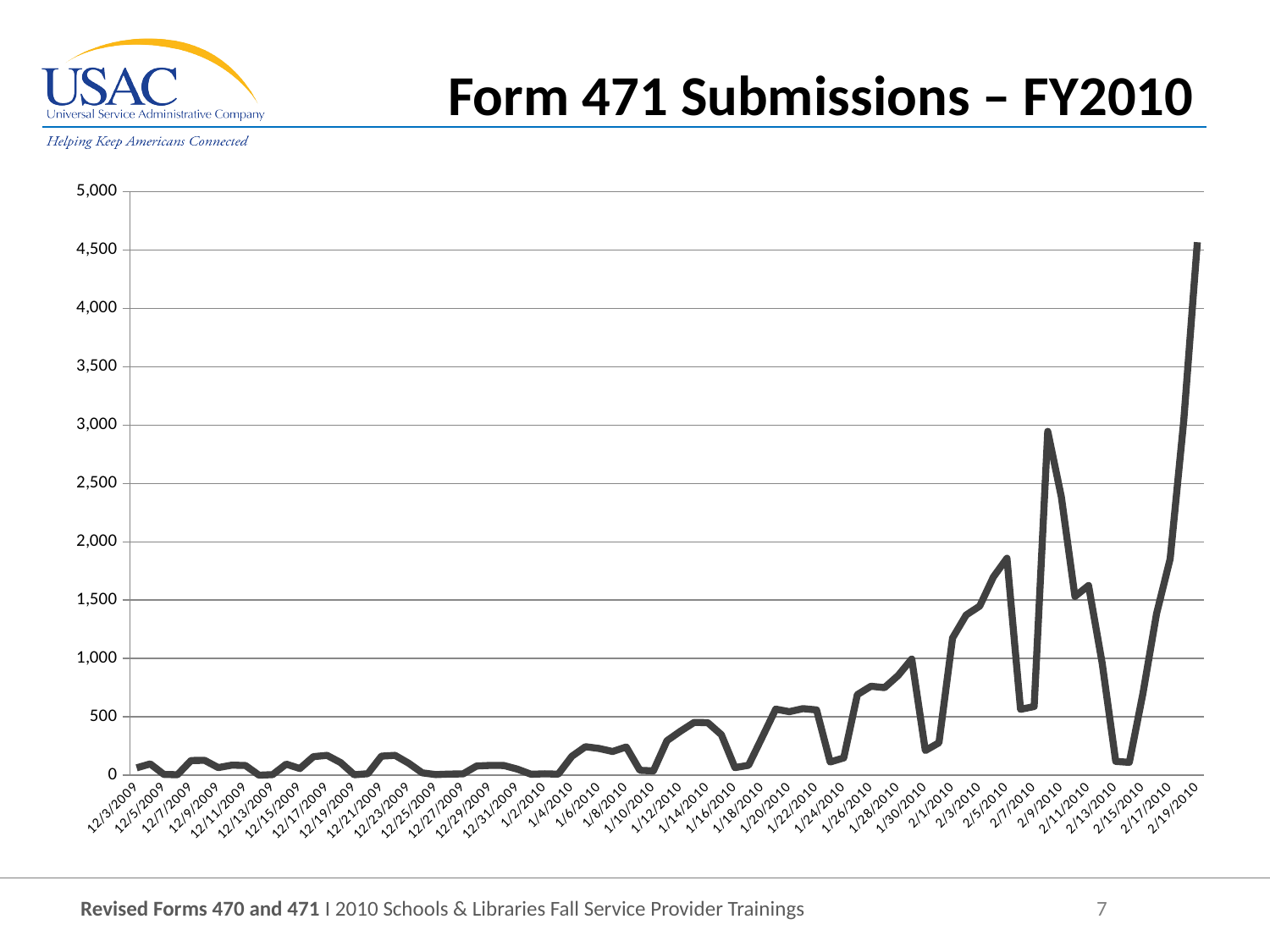
Is the value for 2/9/2010 greater or less than 2,500? less What is the highest value shown on the vertical axis? 5,000 Which date has the highest number of Form 471 submissions? 2/19/2010 Is the value for 2/9/2010 greater or less than 3,000? less Is the value for 2/5/2010 greater or less than 1,500? greater What is the title of the chart? Form 471 Submissions – FY2010 Overall, do the values rise or fall from 12/3/2009 to 2/19/2010? rise What kind of chart is shown on the slide? line chart